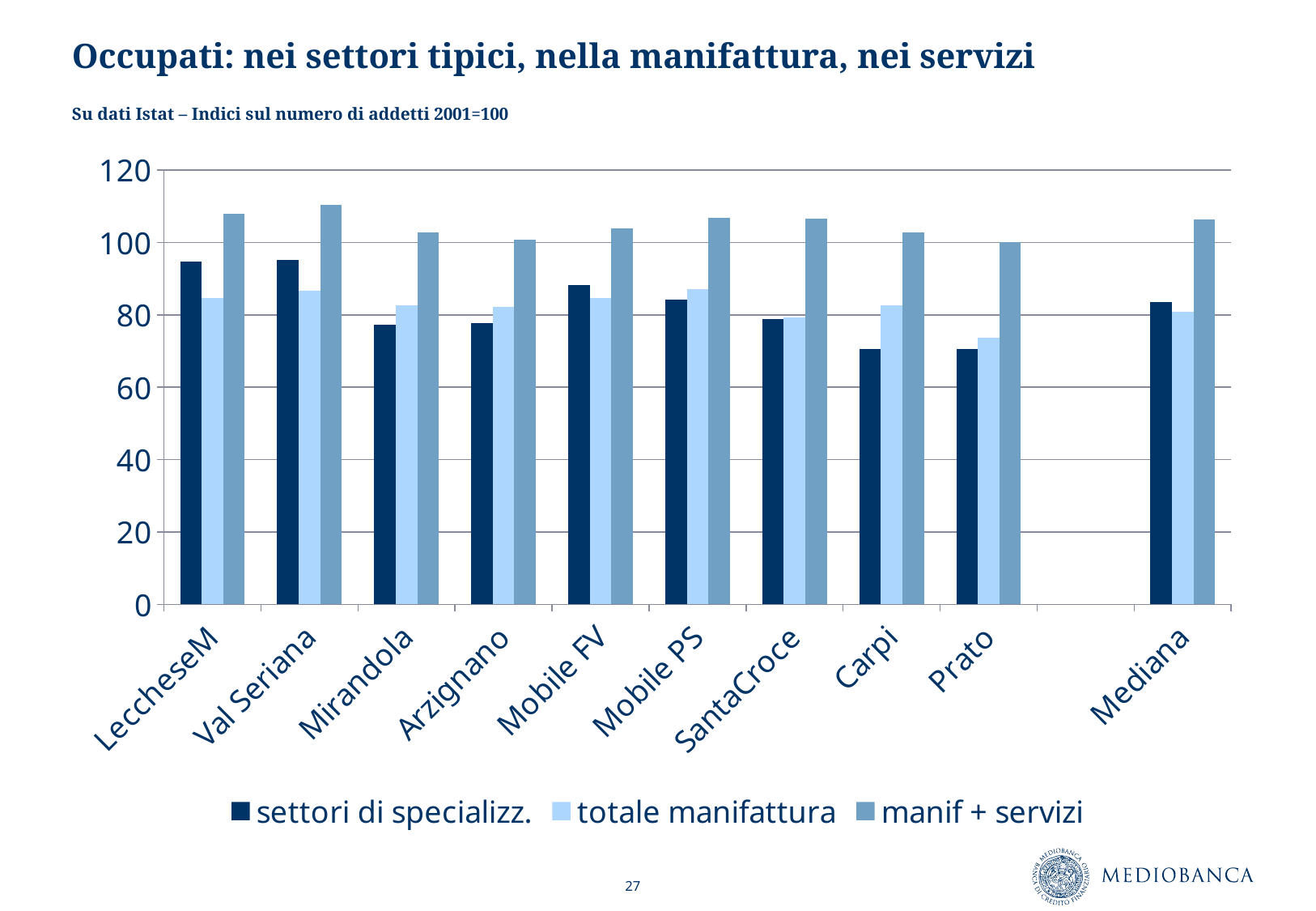
What kind of chart is shown on the slide? bar chart Which category has the lowest value for manif + servizi? Prato In LeccheseM, which is larger: settori di specializz. or totale manifattura? settori di specializz. Which category has the highest value for manif + servizi? Val Seriana How many categories are shown on the x axis? 10 In Carpi, which is larger: settori di specializz. or totale manifattura? totale manifattura What is the title of the chart? Occupati: nei settori tipici, nella manifattura, nei servizi Is the value for manif + servizi in LeccheseM greater or less than 100? greater Is the value for settori di specializz. in Val Seriana greater or less than 80? greater Is the value for settori di specializz. in Carpi greater or less than 80? less How many series does the legend list? 3 Which category has the lowest value for totale manifattura? Prato